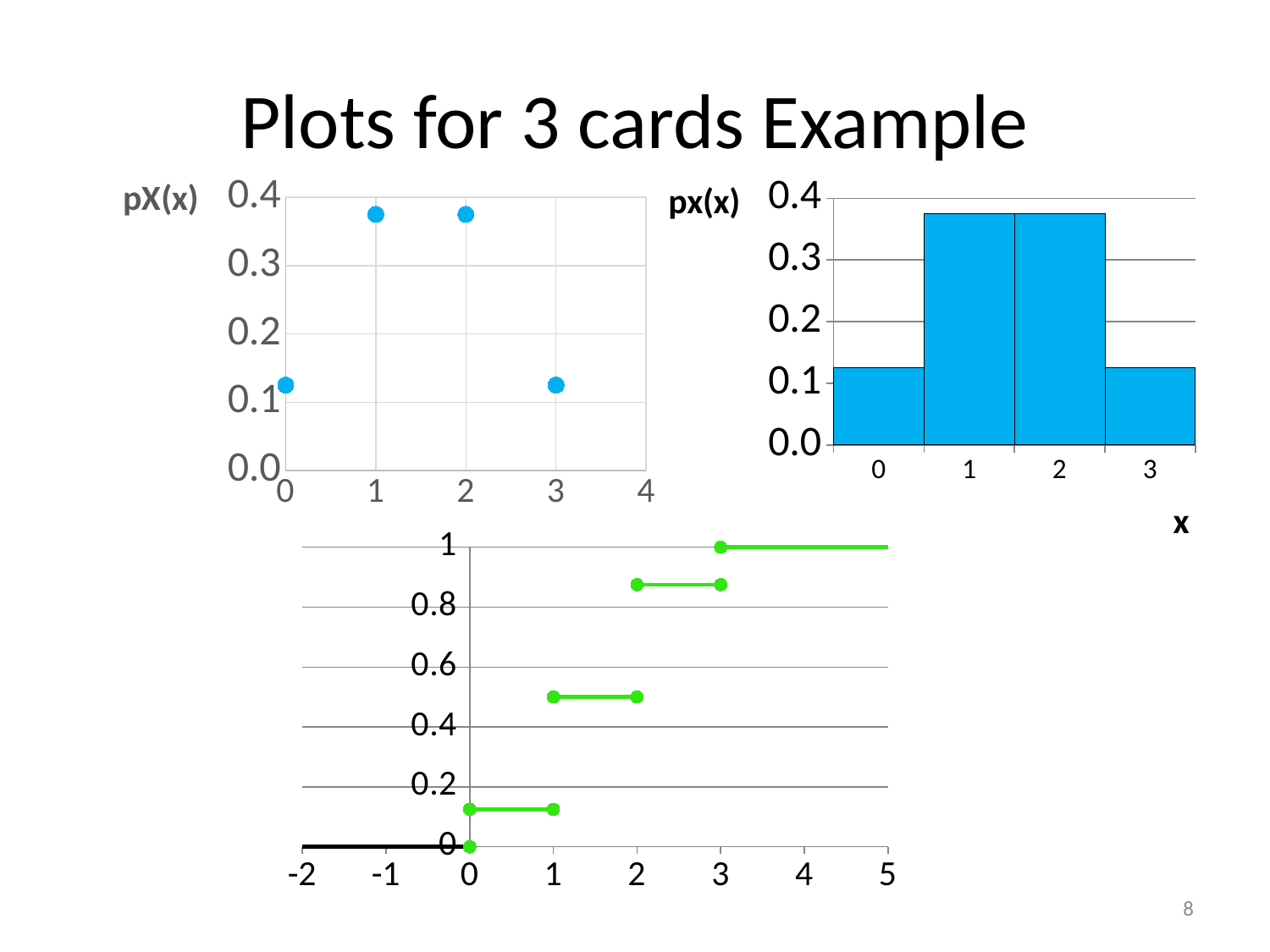
In the top-left chart labelled pX(x), how many data points are plotted? 4 In the top-left chart labelled pX(x), is the value at x = 1 greater or less than 0.3? greater In the top-left chart labelled pX(x), is the value at x = 0 greater or less than 0.2? less In the top-right chart labelled px(x), which bar is taller, category 1 or category 0? category 1 In the bottom step chart, do the values rise or fall as x increases from 0 to 5? rise In the top-right chart labelled px(x), is the bar for category 2 greater or less than 0.3? greater What kind of chart is the top-right chart labelled px(x)? bar chart In the top-right chart labelled px(x), how many bars are there? 4 In the top-left chart labelled pX(x), which is larger, the value at x = 1 or the value at x = 3? x = 1 What kind of chart is the top-left chart labelled pX(x)? scatter chart